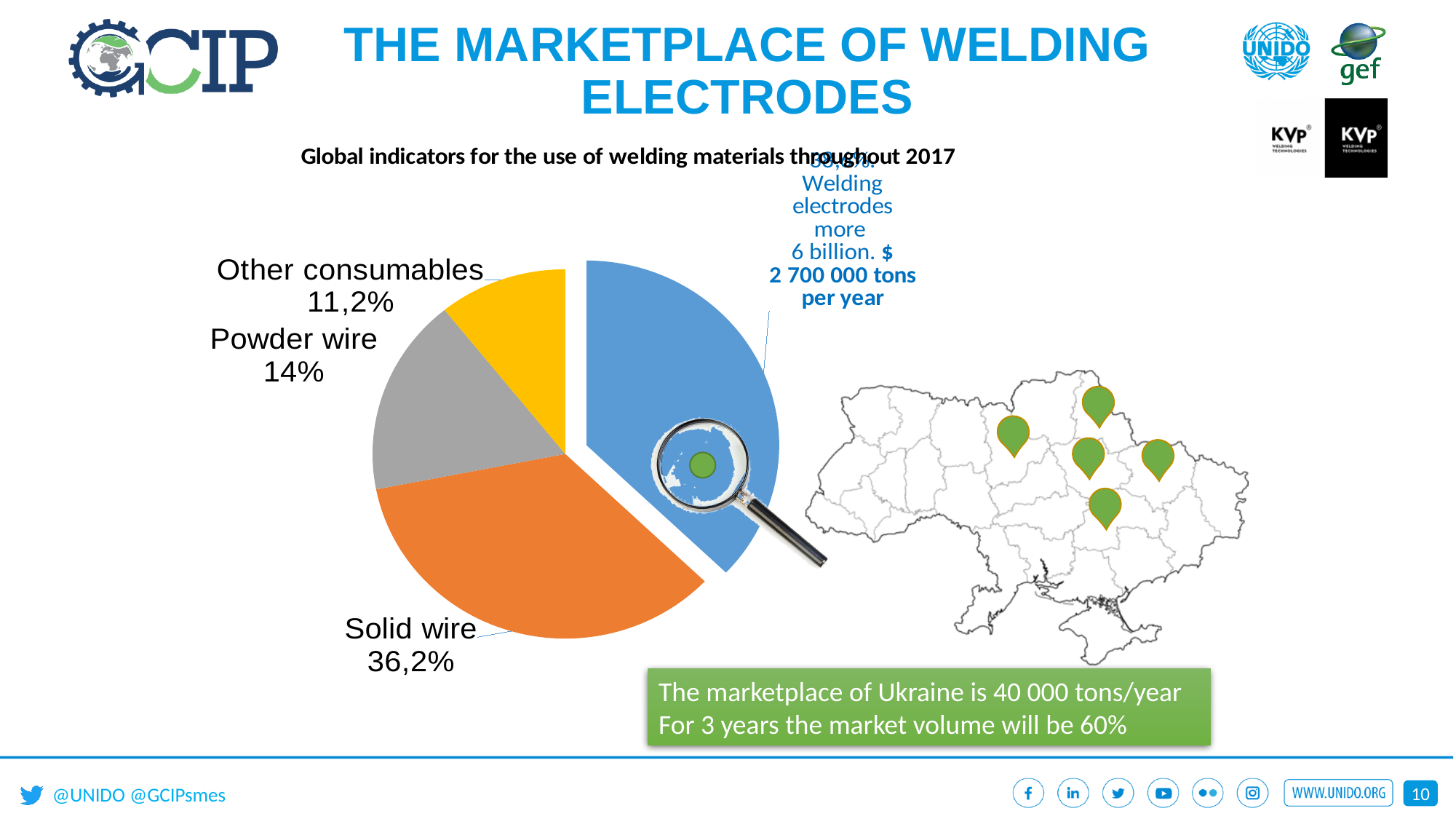
What colour is the Solid wire slice in the pie chart? orange What is the difference between the shares of Solid wire and Powder wire? 22,2% What type of chart is shown on the slide? pie chart How many categories are shown in the pie chart? 4 What is the difference between the shares of Powder wire and Other consumables? 2,8% Which category has the smallest slice in the pie chart? Other consumables What is the share of Powder wire in the pie chart? 14% Which category has the largest slice in the pie chart? Welding electrodes What is the title of the chart? Global indicators for the use of welding materials throughout 2017 What is the share of Other consumables in the pie chart? 11,2% What is the share of Solid wire in the pie chart? 36,2% Which is larger, the share of Solid wire or the share of Powder wire? Solid wire